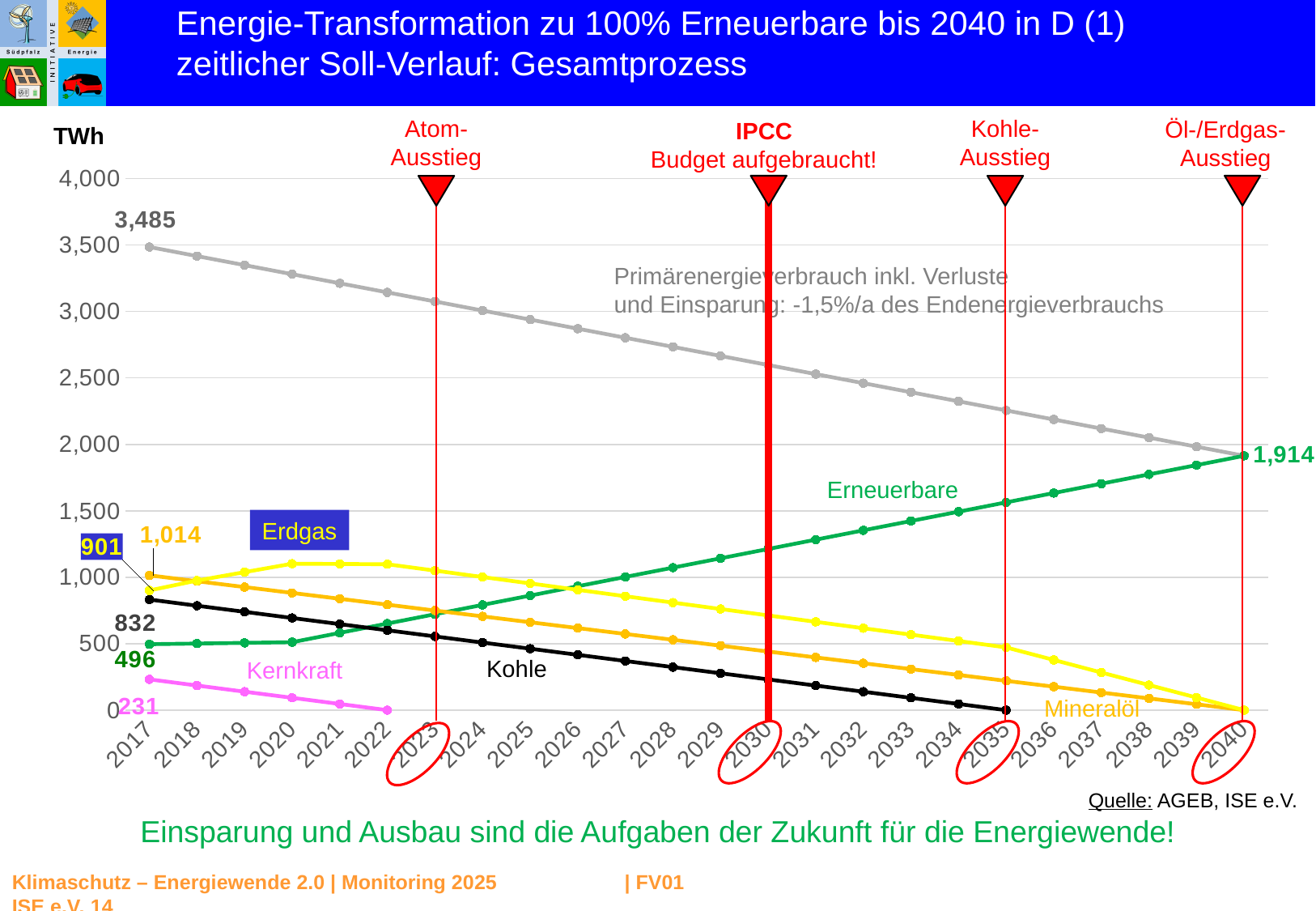
What is the value for Kohle in 2017? 832 What is the value of the Primärenergieverbrauch line in 2017? 3,485 What value does the Erneuerbare line reach in 2040? 1,914 What kind of chart is shown on the slide? line chart How many years are shown on the x axis? 24 Does the Primärenergieverbrauch line rise or fall from 2017 to 2040? fall In which year is the Kohle-Ausstieg marker placed? 2035 What is the value for Kernkraft in 2017? 231 By how much does the Erneuerbare value increase from 2017 to 2040? 1,418 What is the value for Erneuerbare in 2017? 496 In 2017, which is larger: Mineralöl or Erdgas? Mineralöl Is the value for Kohle in 2030 greater or less than 500? less